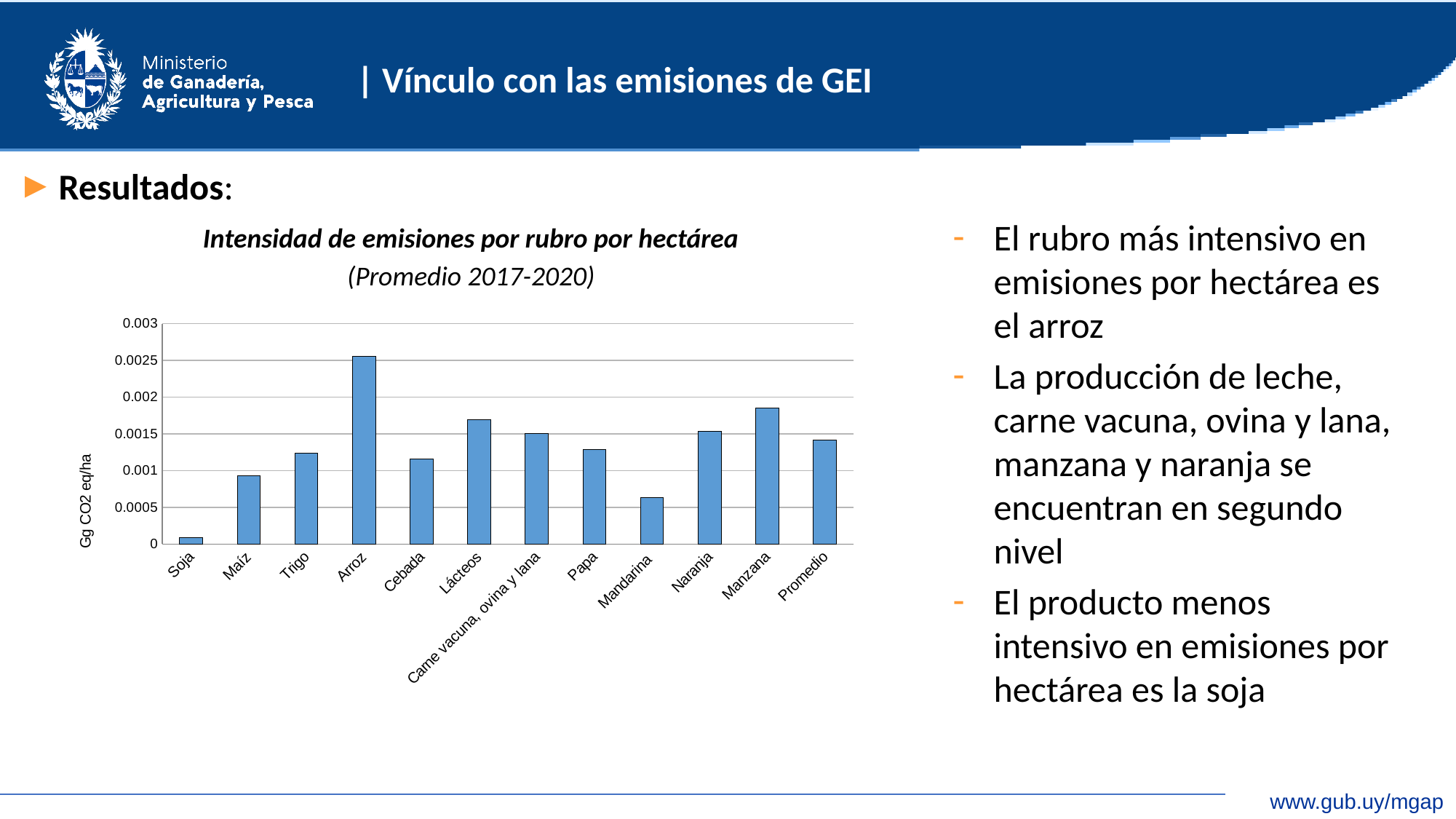
Which is larger, the value for Arroz or the value for Manzana? Arroz Is the value for Lácteos greater or less than 0.0015? greater What kind of chart is shown on the slide? bar chart Is the value for Arroz greater or less than 0.002? greater What is the label on the vertical axis of the chart? Gg CO2 eq/ha Is the value for Mandarina greater or less than 0.001? less Which category has the highest emissions intensity in the chart? Arroz Which category has the lowest emissions intensity in the chart? Soja How many categories are plotted on the x axis of the chart? 12 Which is larger, the value for Mandarina or the value for Maíz? Maíz